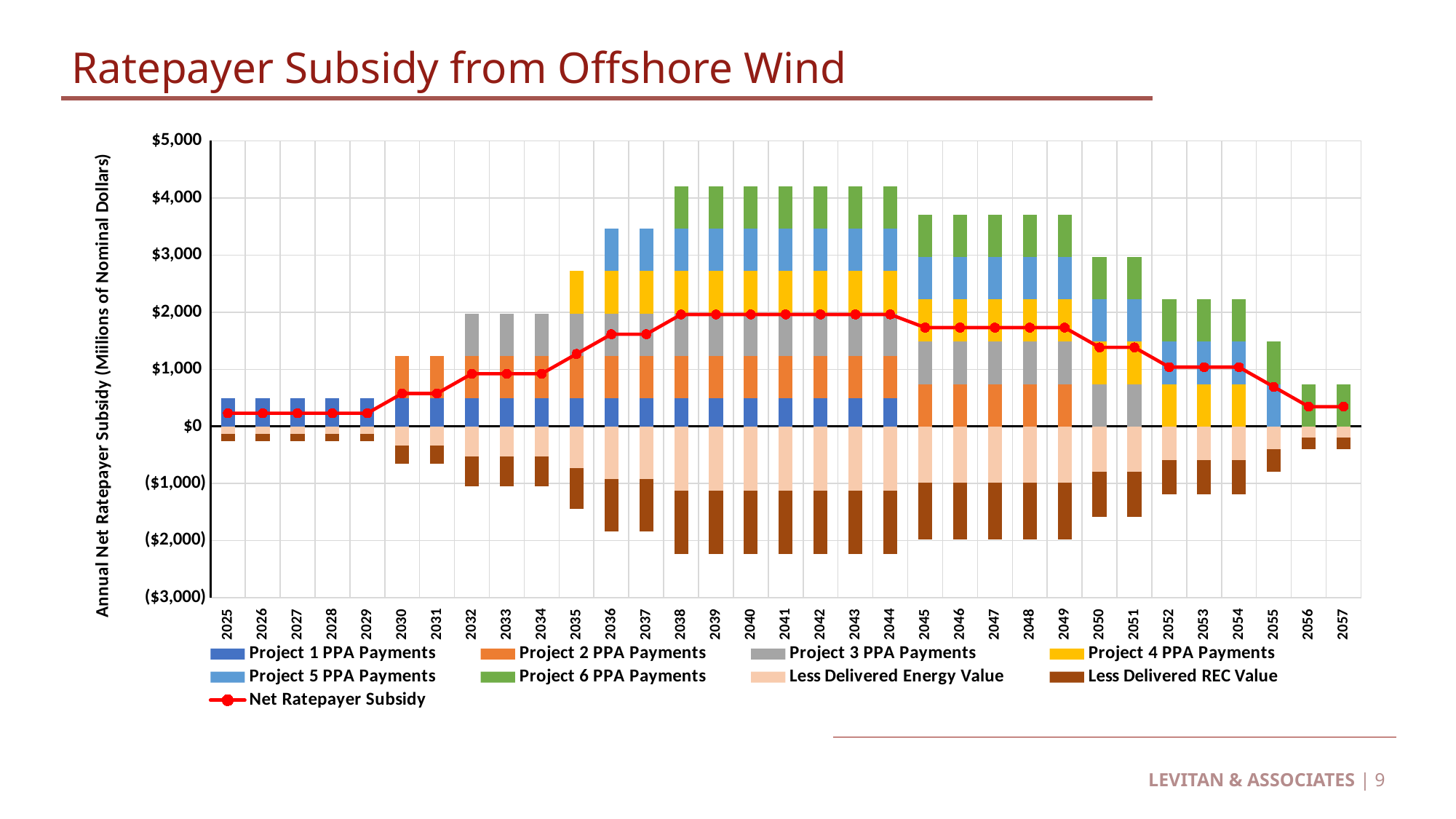
How many series does the legend list? 9 How many years are shown along the x axis? 33 Is the Net Ratepayer Subsidy value for 2057 greater or less than $1,000? less Is the Net Ratepayer Subsidy value for 2045 greater or less than $1,000? greater Is the Net Ratepayer Subsidy value for 2025 greater or less than $1,000? less Which year has the larger Net Ratepayer Subsidy, 2025 or 2040? 2040 Does the Net Ratepayer Subsidy line rise or fall from 2044 to 2057? fall What is the title of the y axis? Annual Net Ratepayer Subsidy (Millions of Nominal Dollars) Which year has the larger Net Ratepayer Subsidy, 2045 or 2057? 2045 Which series is drawn as the red line with markers? Net Ratepayer Subsidy What kind of chart is shown on the slide? stacked bar chart with a line